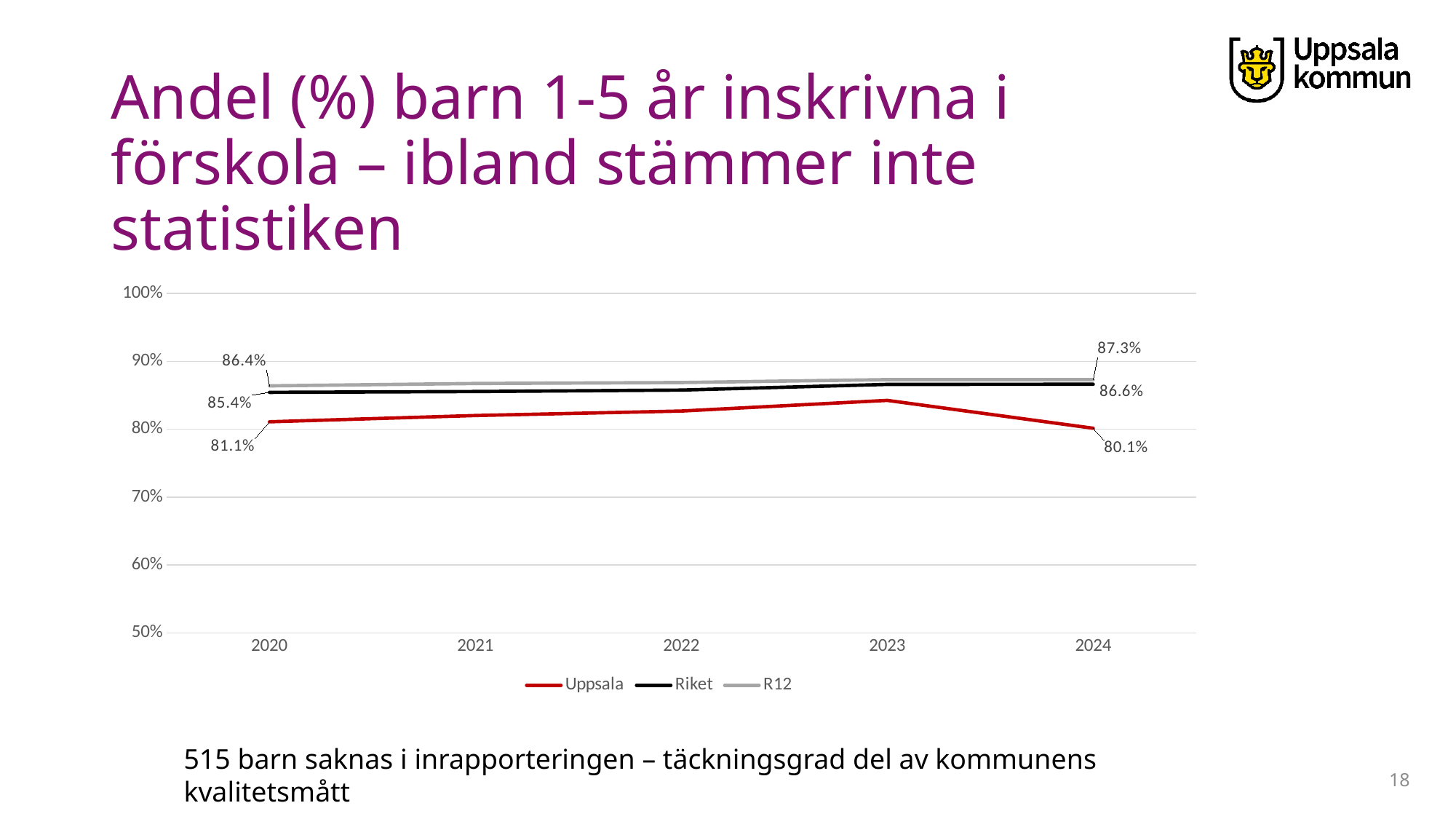
How many series does the legend list? 3 What is the value for Riket in 2020? 85.4% Which series is drawn in red? Uppsala What kind of chart is shown on the slide? line chart Is the value for Uppsala in 2023 greater or less than 80%? greater How many years are shown on the x axis? 5 Is the value for Riket in 2024 greater or less than 86.4%? greater What is the value for R12 in 2024? 87.3% What is the value for Uppsala in 2024? 80.1% What is the difference between the R12 value and the Uppsala value in 2024? 7.2 percentage points What is the value for Uppsala in 2020? 81.1% Which series has the lowest value in 2024? Uppsala